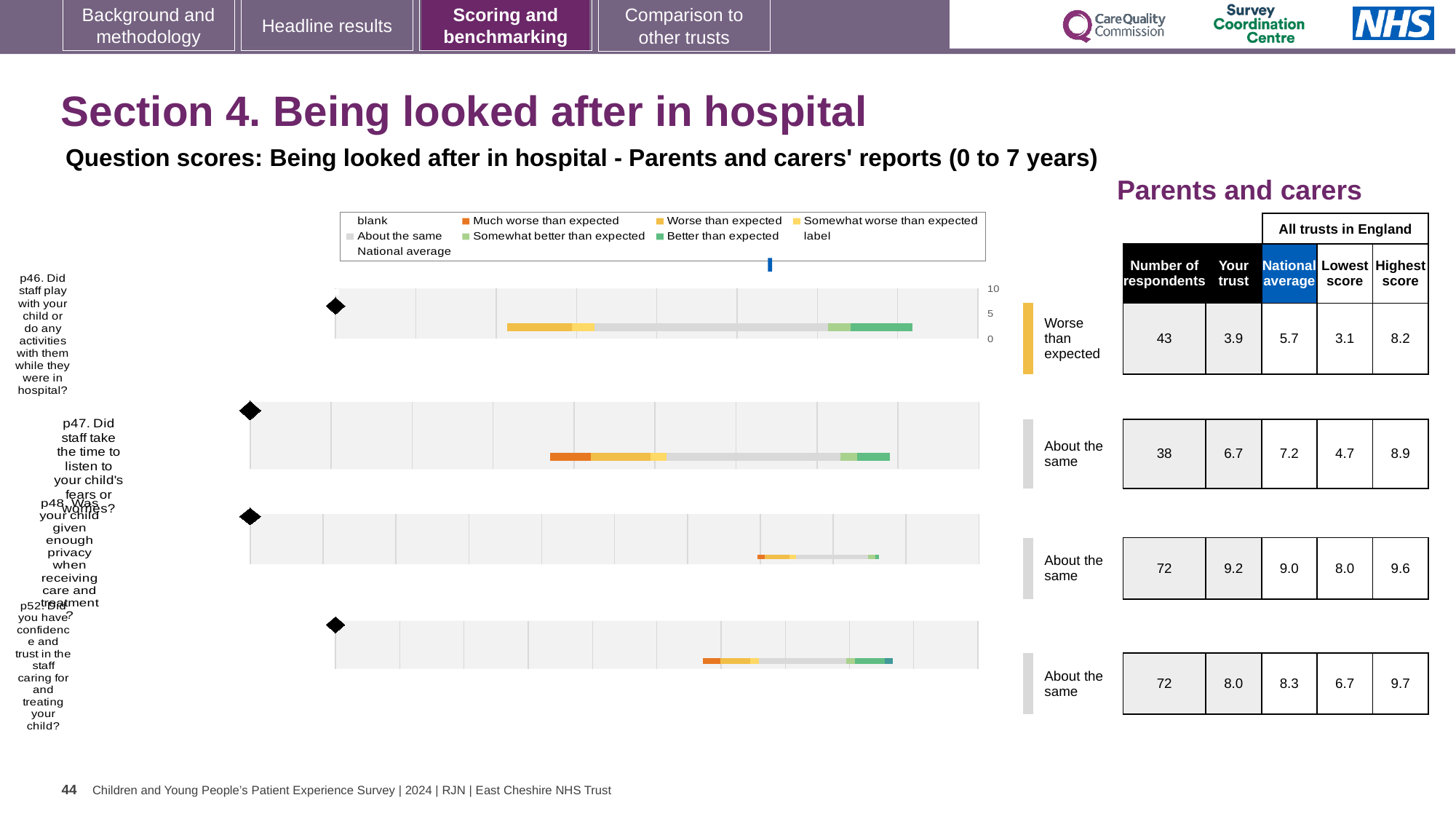
Which question has the lowest 'Your trust' score? p46 What is the national average score for p48 (Was your child given enough privacy when receiving care and treatment?)? 9.0 For p47, what is the difference between the national average and the 'Your trust' score? 0.5 How many questions (bars) are plotted in the chart? 4 How many respondents answered p47 (Did staff take the time to listen to your child's fears or worries?)? 38 For p52, which is larger: the 'Your trust' score or the national average? National average What benchmark label is shown next to the bar for p46? Worse than expected How many entries does the chart legend list? 9 Which question has the highest 'Your trust' score? p48 What is the highest value shown on the chart's score axis? 10 What is the 'Your trust' score for p46 (Did staff play with your child or do any activities with them while they were in hospital?)? 3.9 What kind of chart is used to show the question scores on this slide? bar chart